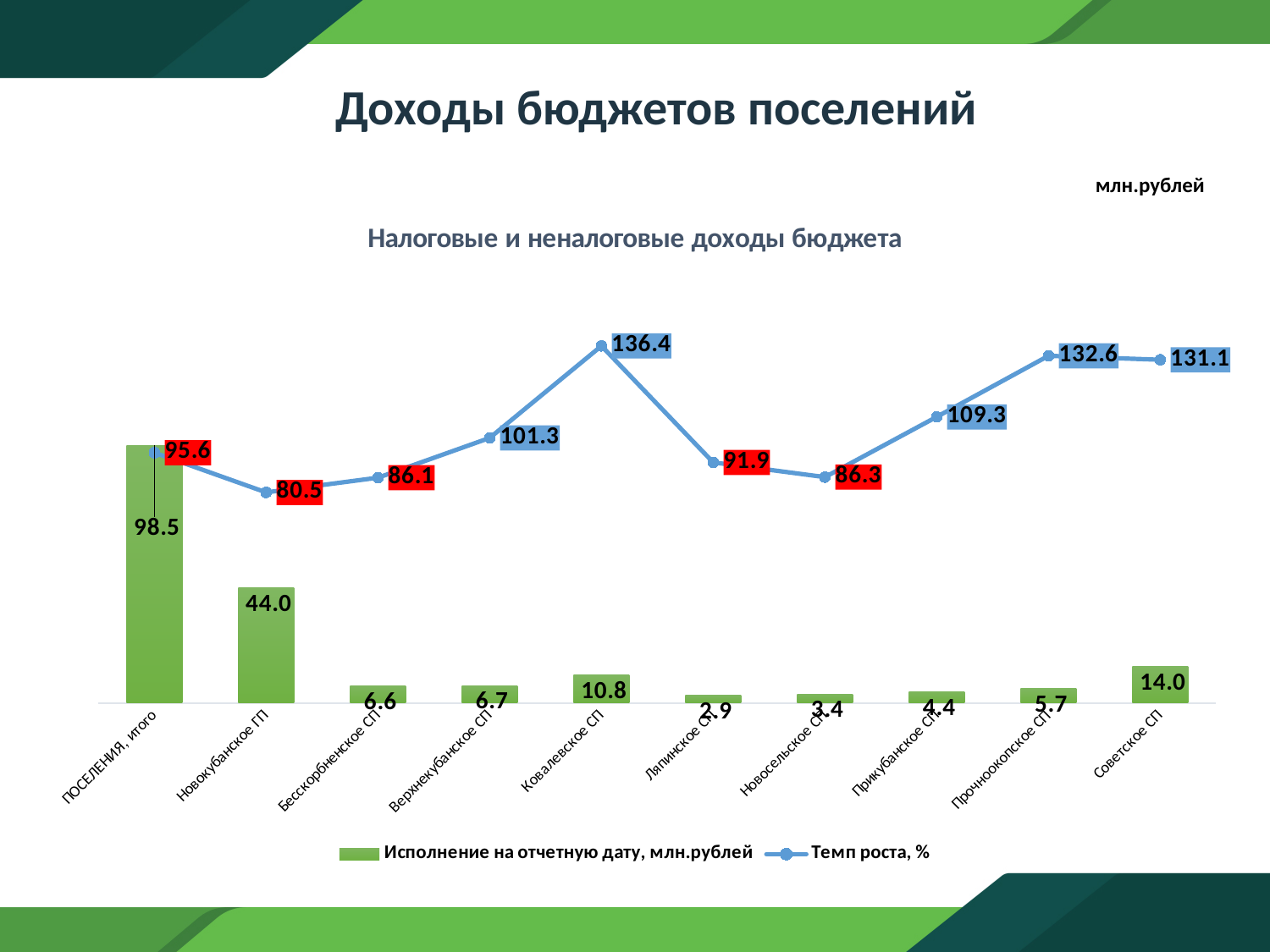
How many series does the legend list? 2 What is the value of 'Исполнение на отчетную дату, млн.рублей' for Новокубанское ГП? 44.0 Which category has the lowest 'Темп роста, %' value? Новокубанское ГП Which has a larger 'Исполнение на отчетную дату, млн.рублей' value: Ковалевское СП or Советское СП? Советское СП How many categories are shown on the x axis? 10 What is the title of the chart? Налоговые и неналоговые доходы бюджета What is the 'Исполнение на отчетную дату, млн.рублей' value for ПОСЕЛЕНИЯ, итого? 98.5 What is the 'Темп роста, %' value for Новокубанское ГП? 80.5 Which category has the lowest 'Исполнение на отчетную дату, млн.рублей' value? Ляпинское СП What is the 'Темп роста, %' value for Ковалевское СП? 136.4 Which category has the highest 'Темп роста, %' value? Ковалевское СП What is the difference between the 'Темп роста, %' values for Прочноокопское СП and Советское СП? 1.5